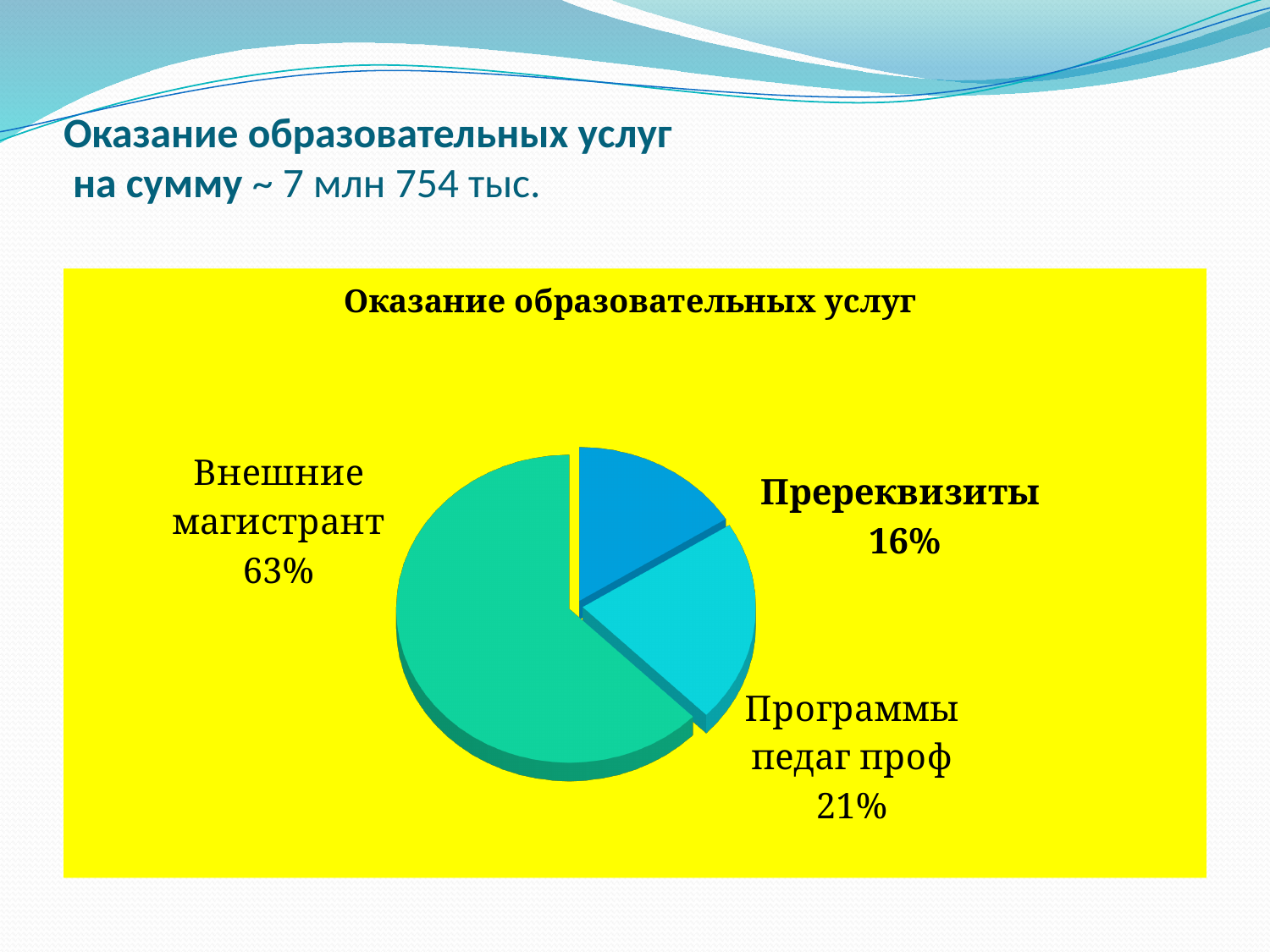
Which slice is the largest? Внешние магистрант What is the difference in percentage points between Программы педаг проф and Пререквизиты? 5 What kind of chart is shown on the slide? pie chart What is the title of the chart? Оказание образовательных услуг Which is larger, Программы педаг проф or Пререквизиты? Программы педаг проф What share of the pie is Программы педаг проф? 21% What is the background colour of the chart area? yellow What share of the pie is Пререквизиты? 16% How many slices does the pie chart have? 3 What share of the pie is Внешние магистрант? 63% Which slice is the smallest? Пререквизиты What is the difference in percentage points between Внешние магистрант and Программы педаг проф? 42